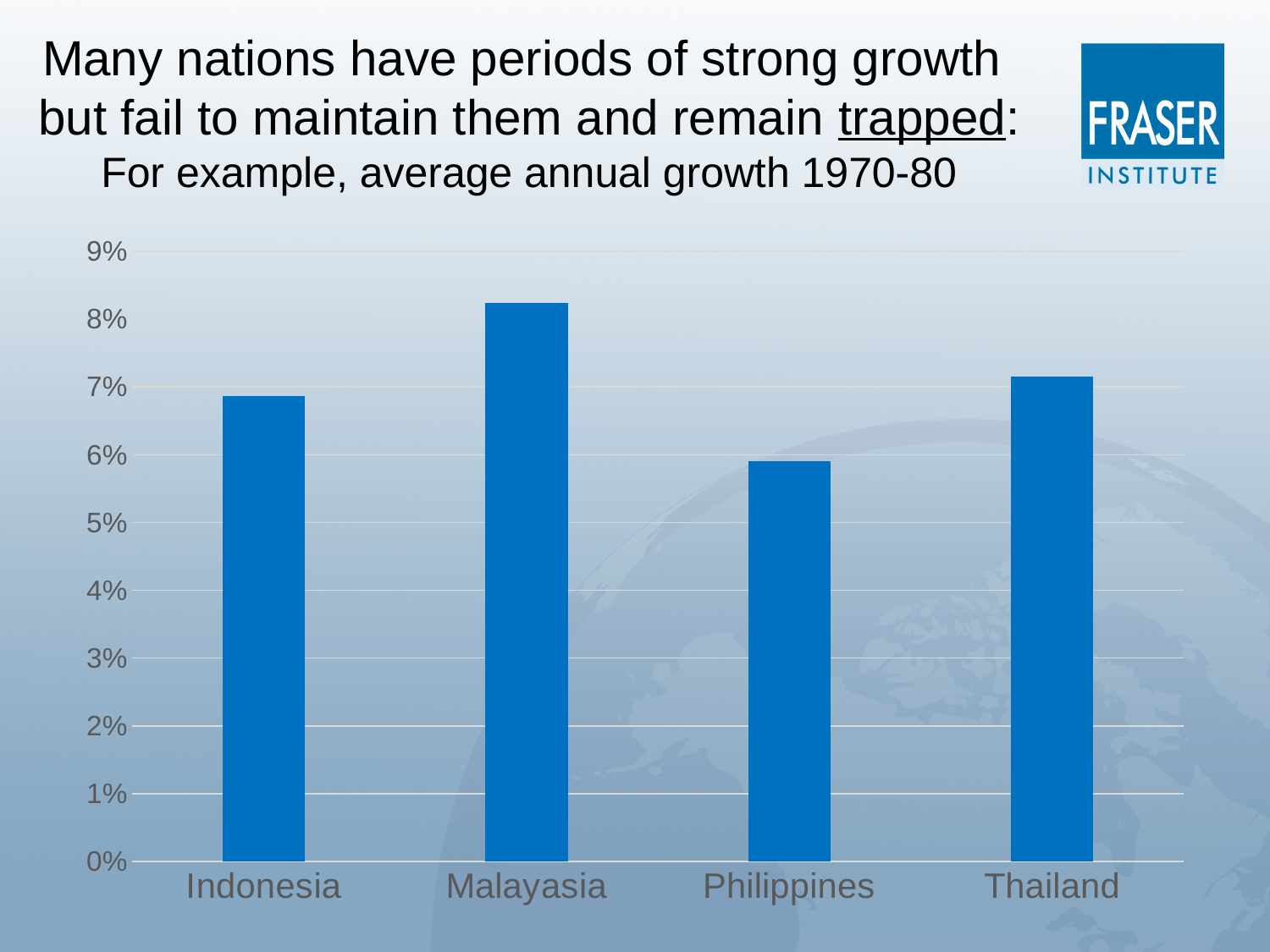
What kind of chart is shown on the slide? bar chart What colour are the bars on the chart? blue Is the value for Philippines greater or less than 5%? greater What period does the chart's average annual growth cover, according to the slide text? 1970-80 Is the value for Malayasia greater or less than 8%? greater Which country has the lowest average annual growth 1970-80 on the chart? Philippines Which has the larger value, Indonesia or Philippines? Indonesia Is the value for Indonesia greater or less than 6%? greater Which country has the highest average annual growth 1970-80 on the chart? Malayasia Which has the larger value, Malayasia or Thailand? Malayasia How many countries are shown on the chart? 4